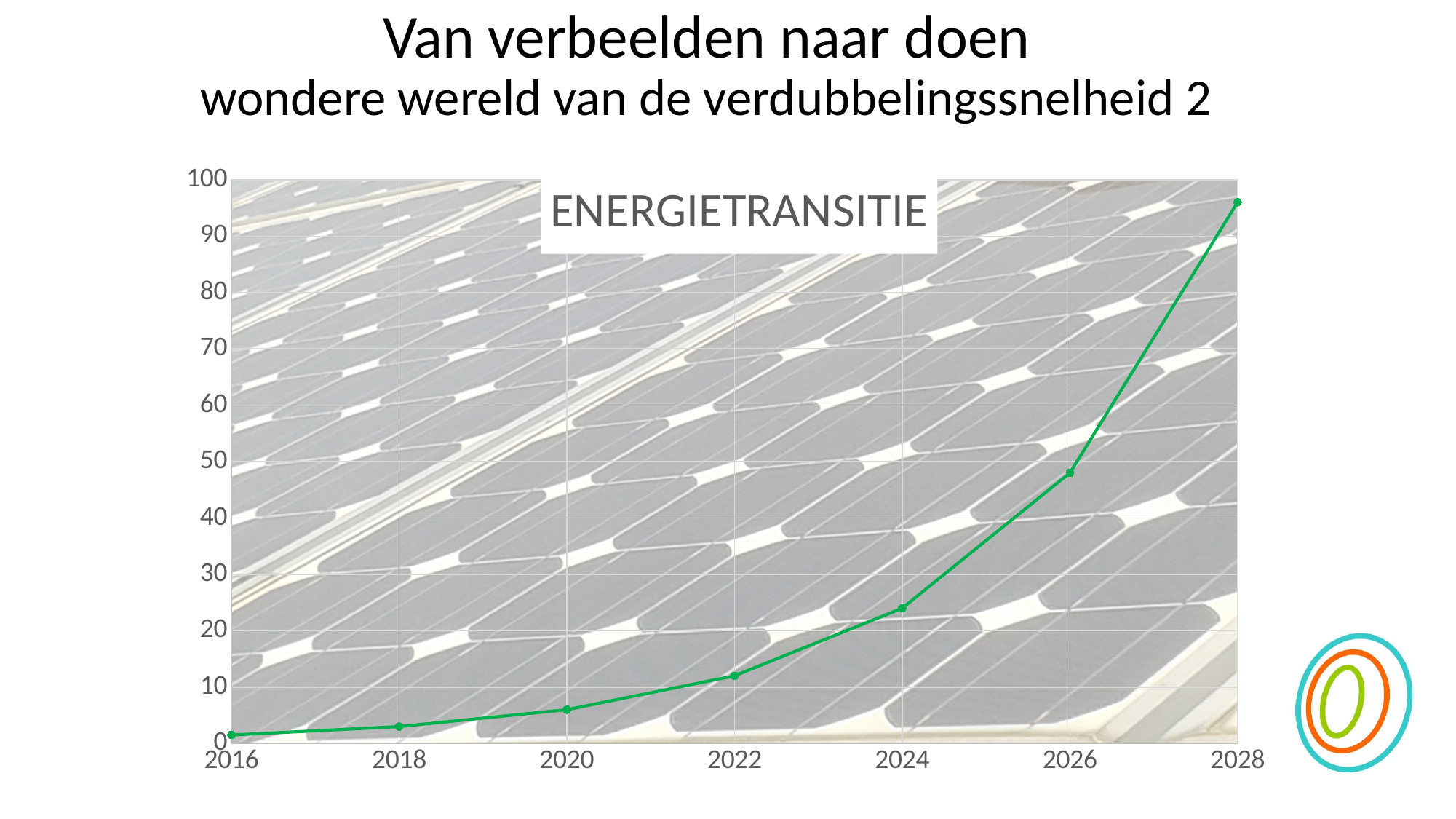
Do the values rise or fall from 2016 to 2028? rise Is the value for 2022 greater or less than 20? less Which year has the highest value? 2028 What colour is the plotted line? green Is the value for 2024 greater or less than 20? greater Is the value for 2028 greater or less than 90? greater What is the title of the chart? ENERGIETRANSITIE Which year has the lowest value? 2016 How many data points are plotted on the line? 7 Which year has the larger value, 2024 or 2026? 2026 What kind of chart is shown on the slide? line chart